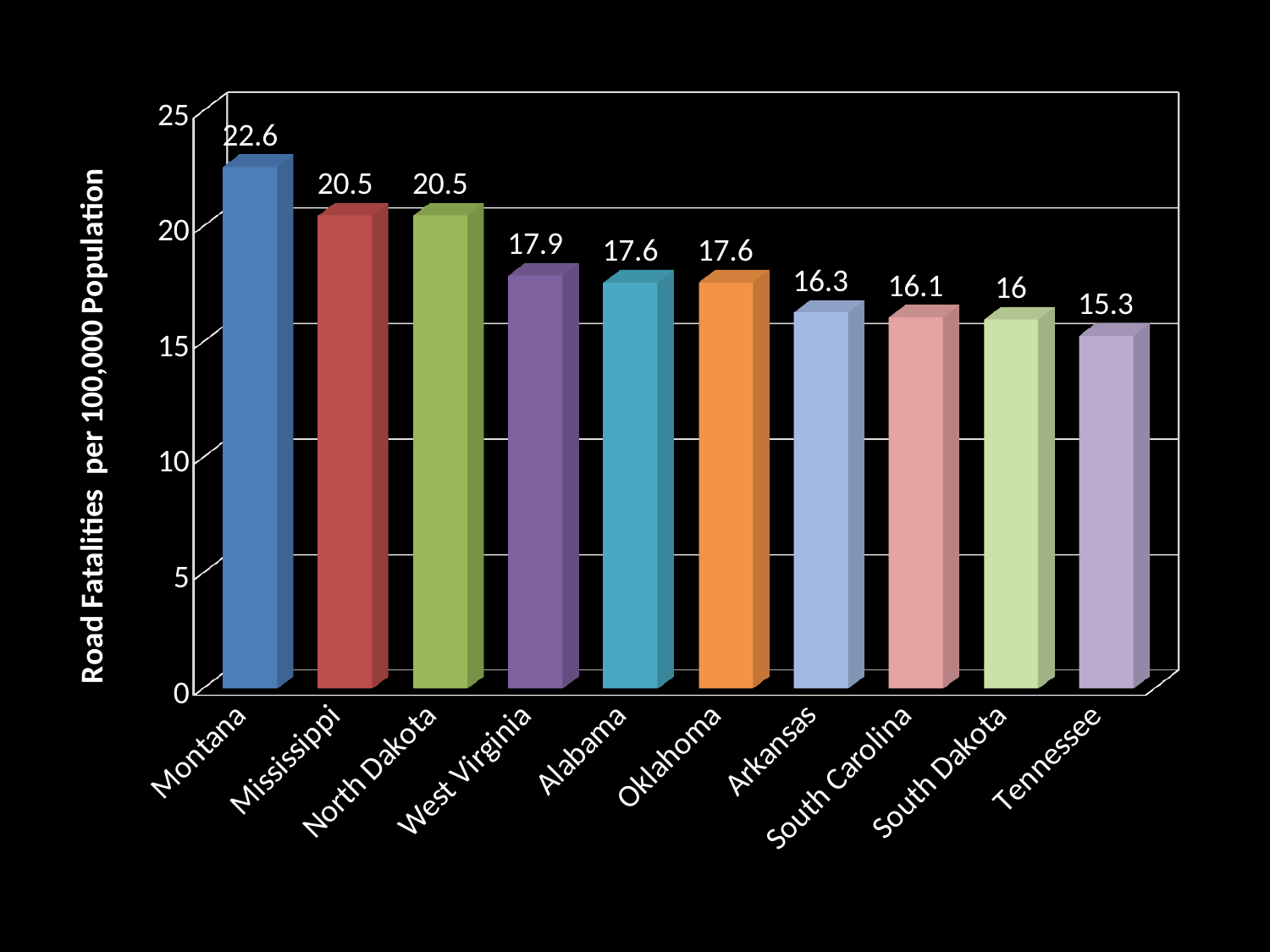
What is the difference between the values for Montana and Tennessee? 7.3 Which has a larger value, Alabama or South Dakota? Alabama Which state has the highest road fatalities per 100,000 population? Montana How many states are shown on the chart? 10 What kind of chart is shown on the slide? bar chart What is the road fatalities per 100,000 population value for Montana? 22.6 Which state has the lowest road fatalities per 100,000 population? Tennessee What is the value shown for South Carolina? 16.1 What is the label on the vertical axis? Road Fatalities per 100,000 Population What is the difference between the values for Mississippi and Arkansas? 4.2 What is the value shown for West Virginia? 17.9 Is the value for Oklahoma greater or less than 20? less